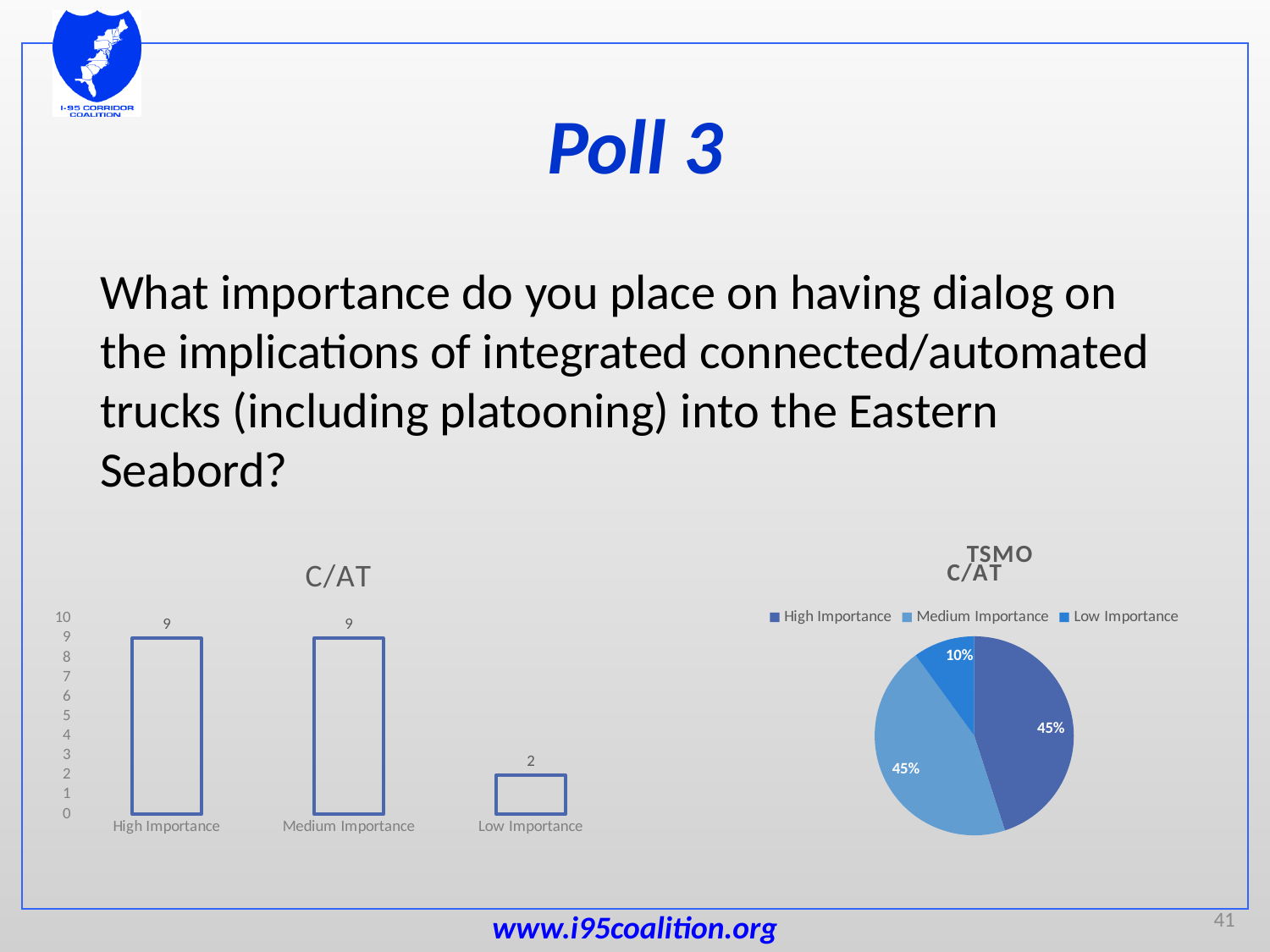
In the pie chart on the right, what share does High Importance have? 45% In the C/AT bar chart on the left, what is the value for High Importance? 9 In the pie chart on the right, which slice is the smallest? Low Importance What kind of chart is the C/AT chart on the left of the slide? Bar chart In the C/AT bar chart on the left, which category has the lowest value? Low Importance In the C/AT bar chart on the left, what is the difference between the High Importance and Low Importance values? 7 In the C/AT bar chart on the left, what is the value for Medium Importance? 9 How many categories are shown in the C/AT bar chart on the left? 3 In the pie chart on the right, what share does Low Importance have? 10% How many entries does the legend of the pie chart on the right list? 3 In the C/AT bar chart on the left, what is the value for Low Importance? 2 In the C/AT bar chart on the left, which is larger: Medium Importance or Low Importance? Medium Importance